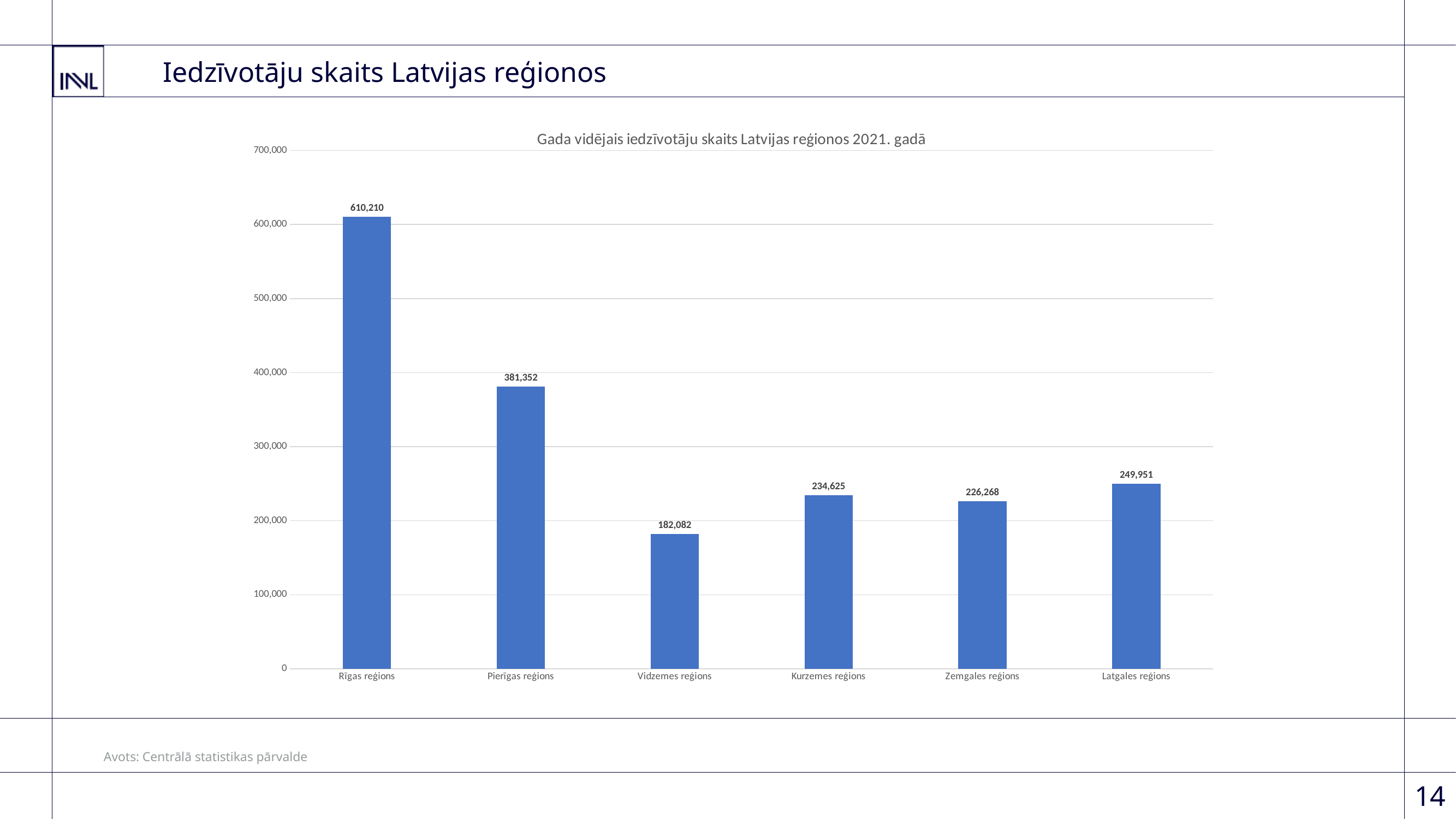
What is the difference between the values for Latgales reģions and Kurzemes reģions? 15,326 Which region has the lowest value? Vidzemes reģions How many regions are shown on the chart? 6 What is the difference between the values for Rīgas reģions and Pierīgas reģions? 228,858 What is the value for Rīgas reģions? 610,210 What is the title of the chart? Gada vidējais iedzīvotāju skaits Latvijas reģionos 2021. gadā Which region has the highest value? Rīgas reģions Which is larger, the value for Kurzemes reģions or Zemgales reģions? Kurzemes reģions What kind of chart is shown on the slide? bar chart What is the value for Latgales reģions? 249,951 Is the value for Pierīgas reģions greater or less than 400,000? less What is the value for Vidzemes reģions? 182,082